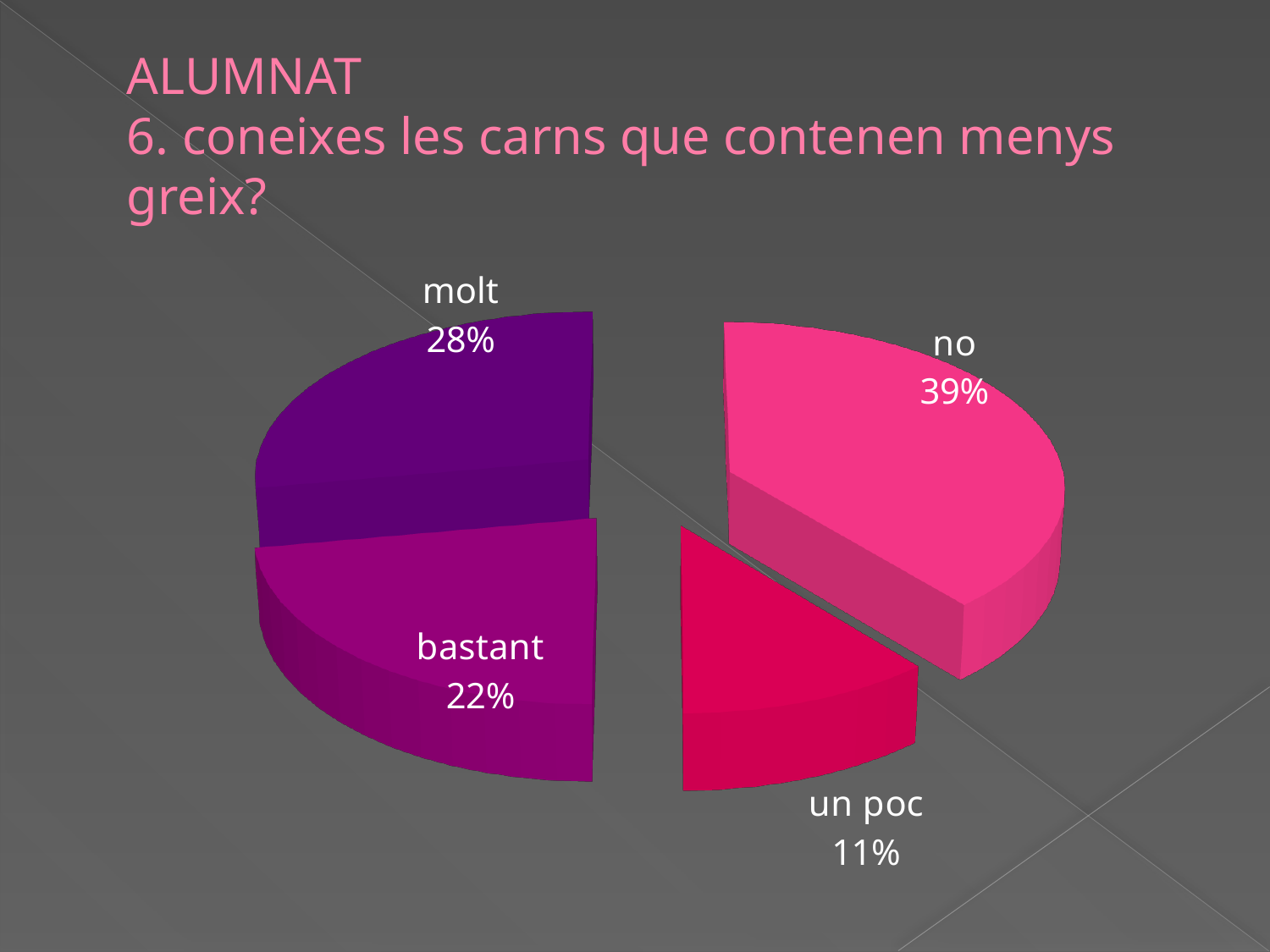
What is the question number shown in the slide title? 6 What percentage of the pie is the "un poc" slice? 11% Which is larger, the "molt" slice or the "bastant" slice? molt What is the difference in percentage points between the "no" slice and the "un poc" slice? 28 What is the difference in percentage points between the "molt" slice and the "bastant" slice? 6 What kind of chart is shown on the slide? pie chart Which slice of the pie is the largest? no What percentage of the pie is the "no" slice? 39% Which slice of the pie is the smallest? un poc What percentage of the pie is the "molt" slice? 28% How many slices does the pie chart have? 4 What percentage of the pie is the "bastant" slice? 22%